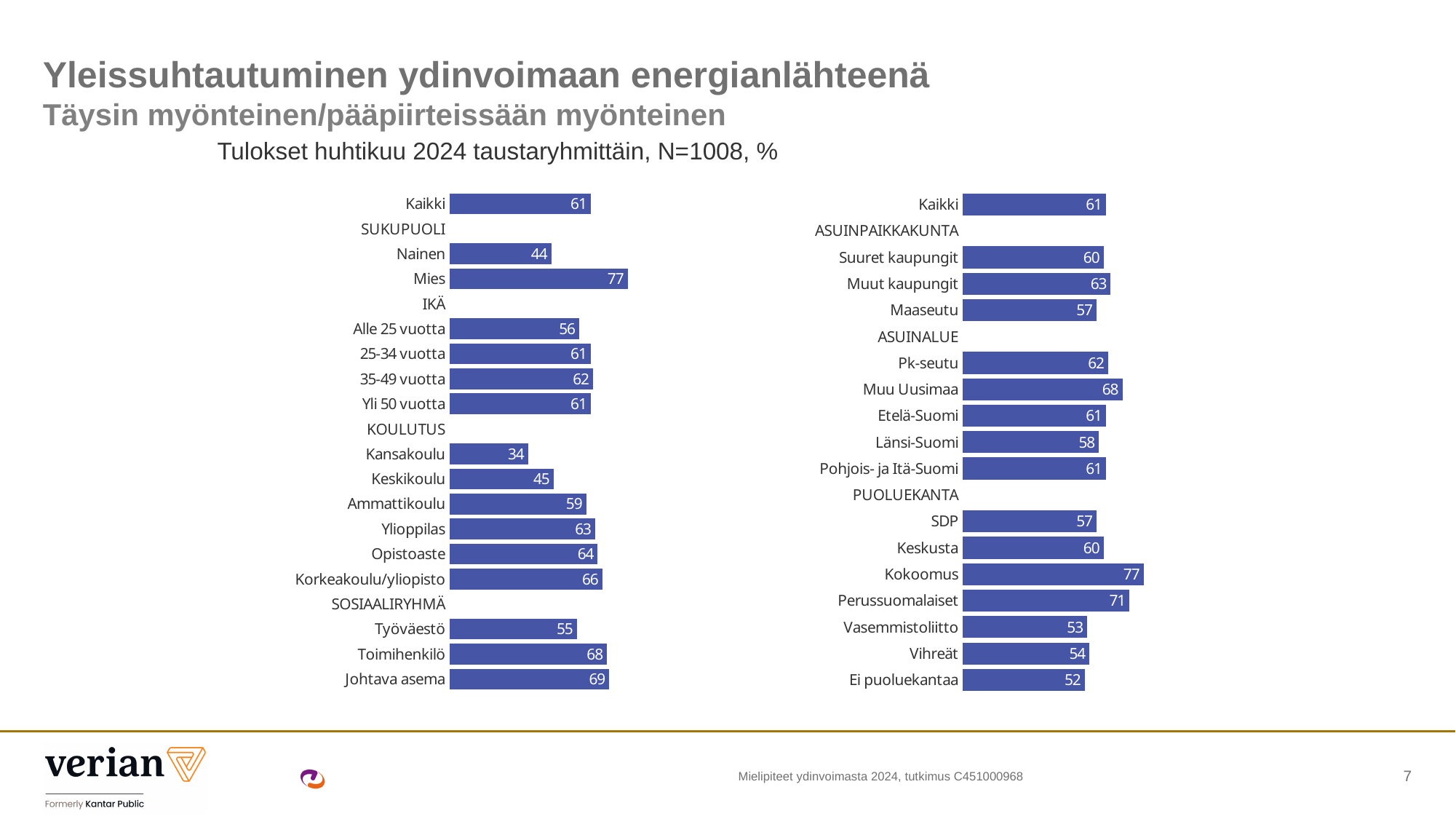
In the left chart, which category has the lowest value? Kansakoulu In the left chart, what is the difference between the values for Mies and Nainen? 33 In the right chart, which category has the highest value? Kokoomus In the right chart, what is the difference between the values for Kokoomus and Ei puoluekantaa? 25 In the right chart, what is the value for Kaikki? 61 What kind of chart is shown on the left side of the slide? Bar chart In the right chart, what is the value for Muu Uusimaa? 68 In the right chart, which is larger, the value for Muut kaupungit or the value for Maaseutu? Muut kaupungit In the right chart, what is the value for Perussuomalaiset? 71 In the left chart, what is the value for Kansakoulu? 34 In the left chart, which is larger, the value for Toimihenkilö or the value for Työväestö? Toimihenkilö In the left chart, what is the value for Mies? 77